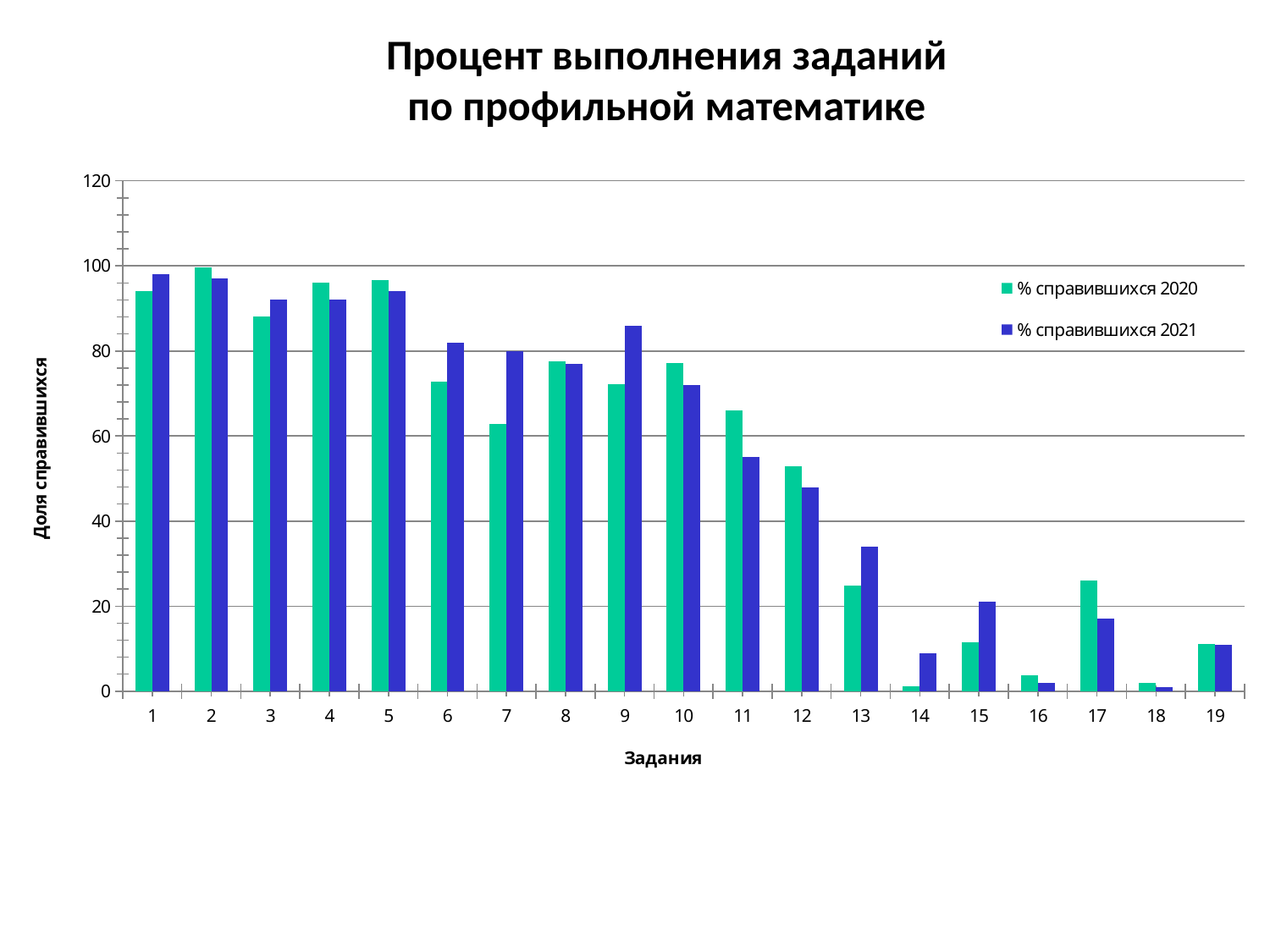
What is the label of the vertical axis? Доля справившихся What kind of chart is shown on the slide? bar chart Which task has the highest value for the series "% справившихся 2020"? 2 Is the value for task 7 in the series "% справившихся 2020" greater or less than 60? greater For task 11, which series has the larger value: "% справившихся 2020" or "% справившихся 2021"? % справившихся 2020 Is the value for task 9 in the series "% справившихся 2021" greater or less than 80? greater How many tasks (categories) are shown on the x axis? 19 How many series does the legend list? 2 Is the value for task 13 in the series "% справившихся 2021" greater or less than 40? less For task 9, which series has the larger value: "% справившихся 2020" or "% справившихся 2021"? % справившихся 2021 Do the values generally rise or fall as the task number increases along the x axis? fall